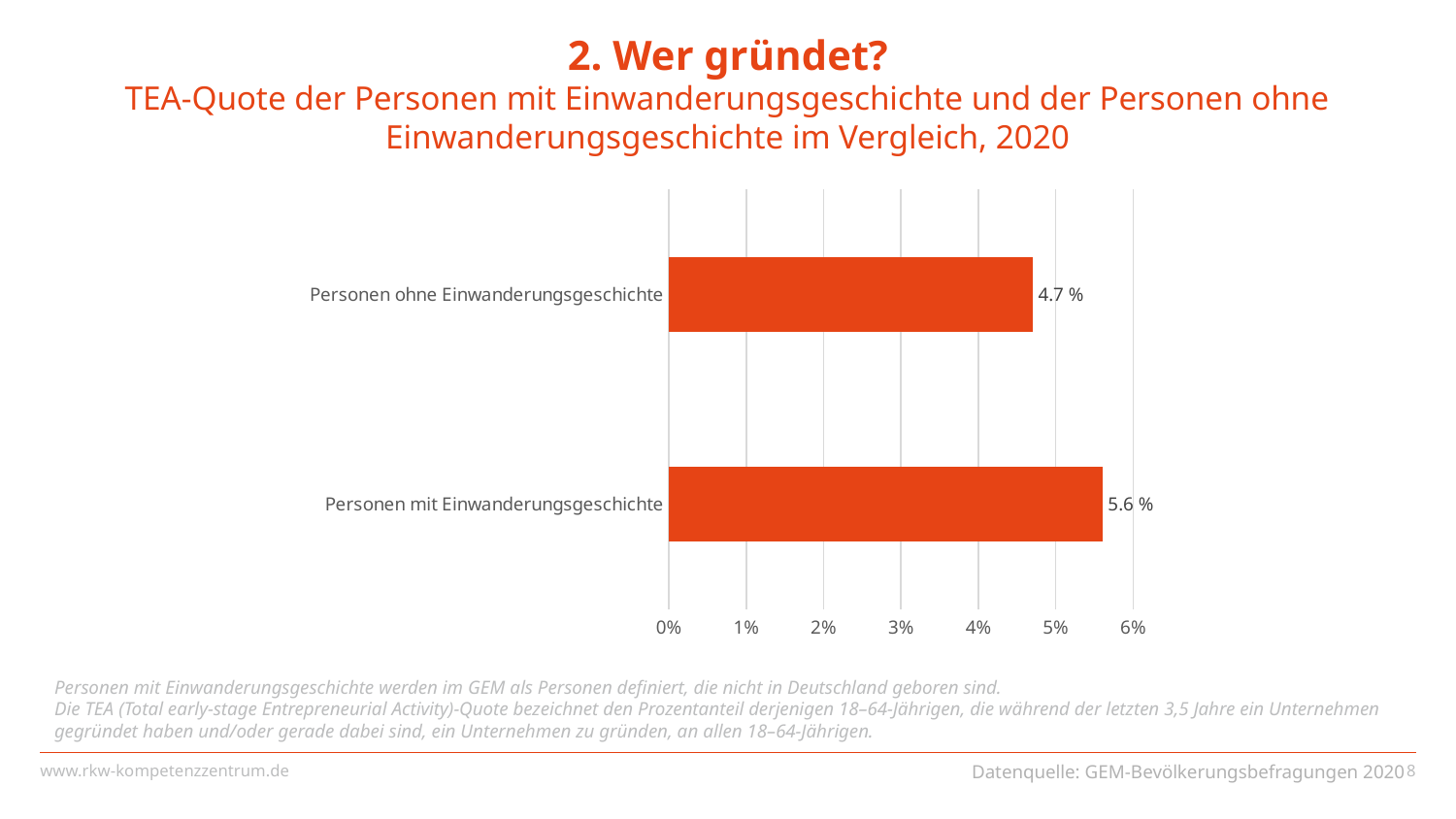
Which category has the lower TEA-Quote? Personen ohne Einwanderungsgeschichte What kind of chart is shown on the slide? Bar chart How many categories are shown in the chart? 2 What is the TEA-Quote for Personen ohne Einwanderungsgeschichte? 4.7 % What is the difference between the TEA-Quote of Personen mit Einwanderungsgeschichte and Personen ohne Einwanderungsgeschichte? 0.9 % Is the value for Personen ohne Einwanderungsgeschichte greater or less than 5%? less Which category has the higher TEA-Quote? Personen mit Einwanderungsgeschichte What is the TEA-Quote for Personen mit Einwanderungsgeschichte? 5.6 % Is the value for Personen mit Einwanderungsgeschichte greater or less than 5%? greater What year does the chart's data refer to, according to the subtitle? 2020 Is the TEA-Quote higher for Personen mit Einwanderungsgeschichte or for Personen ohne Einwanderungsgeschichte? Personen mit Einwanderungsgeschichte What is the highest value shown on the x axis of the chart? 6%